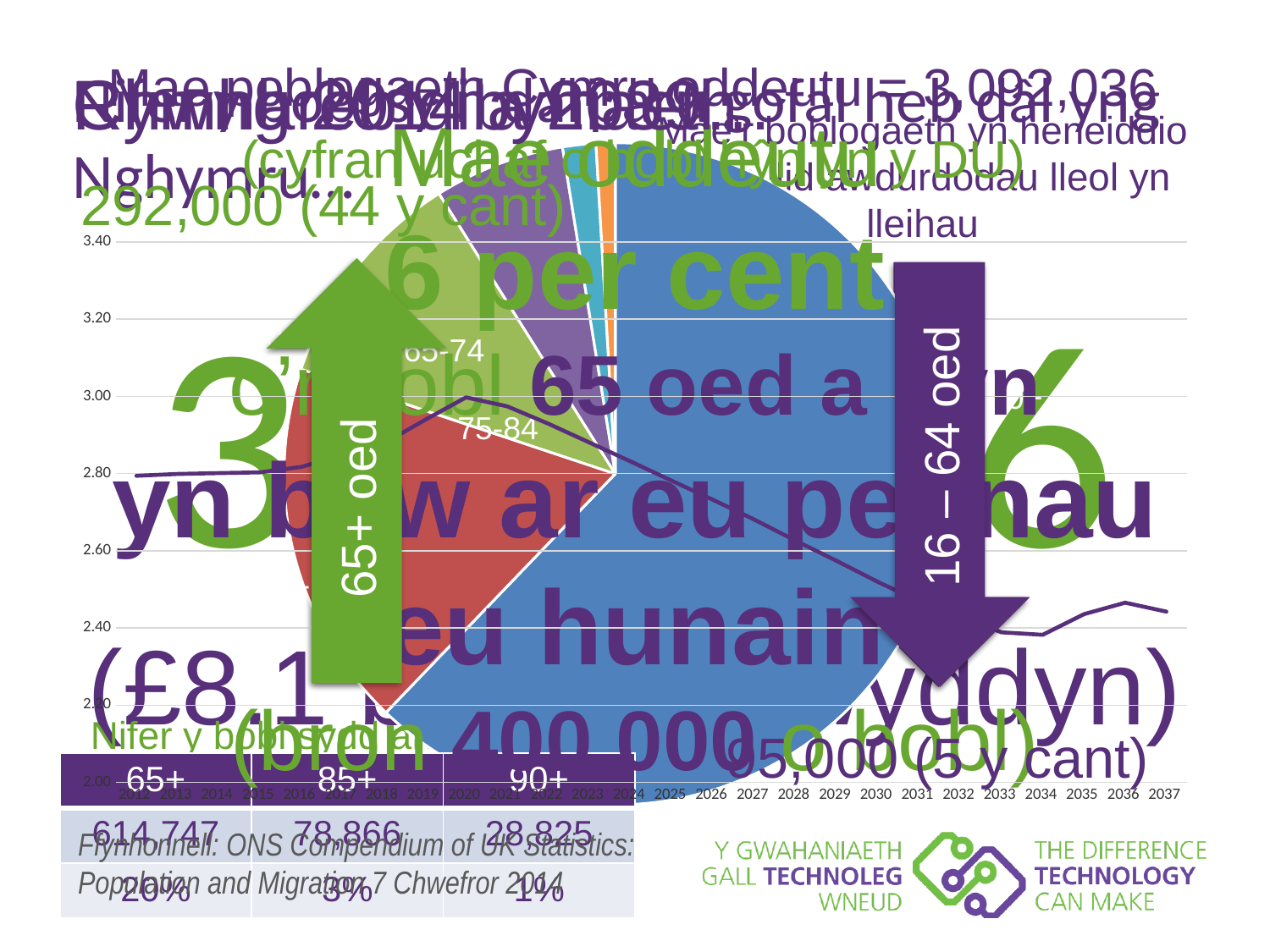
What kind of chart is the one with slices labelled 65-74 and 75-84? pie chart On the line chart, is the value for 2012 greater or less than 2.60? greater On the line chart, do the values rise or fall between 2025 and 2037? fall What kind of chart is the one with years from 2012 to 2037 along the x axis? line chart On the line chart, do the values rise or fall between 2012 and 2019? rise On the line chart, is the value for 2020 greater or less than 2.80? greater On the line chart, what is the lowest value shown on the y axis? 2.00 On the line chart, is the value for 2037 greater or less than 2.60? less On the line chart, how many years are shown along the x axis? 26 On the line chart, what is the highest value shown on the y axis? 3.40